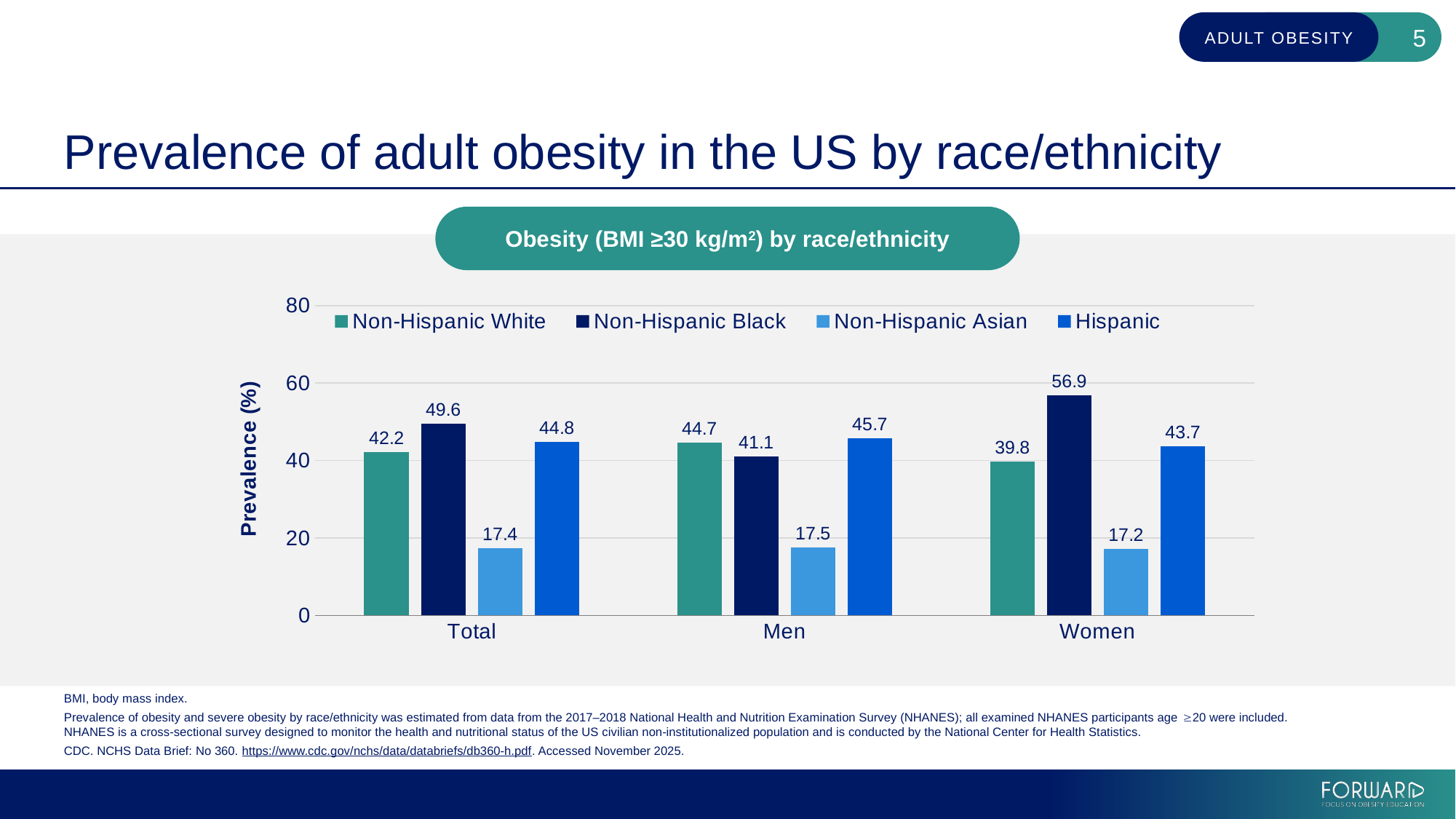
How many series does the legend list? 4 What is the obesity prevalence for Non-Hispanic Black women? 56.9 What is the label of the y axis? Prevalence (%) How many categories are shown on the x axis? 3 What is the difference between the obesity prevalence of Non-Hispanic Black women and Non-Hispanic White women? 17.1 What is the obesity prevalence for Non-Hispanic Asian adults in the Total group? 17.4 What kind of chart is shown on the slide? Bar chart What is the obesity prevalence for Hispanic men? 45.7 Which is larger: the obesity prevalence for Non-Hispanic White men or Non-Hispanic Black men? Non-Hispanic White men Is the obesity prevalence for Non-Hispanic Black women greater or less than 40? greater Which race/ethnicity group has the highest obesity prevalence among women? Non-Hispanic Black Which race/ethnicity group has the lowest obesity prevalence among men? Non-Hispanic Asian